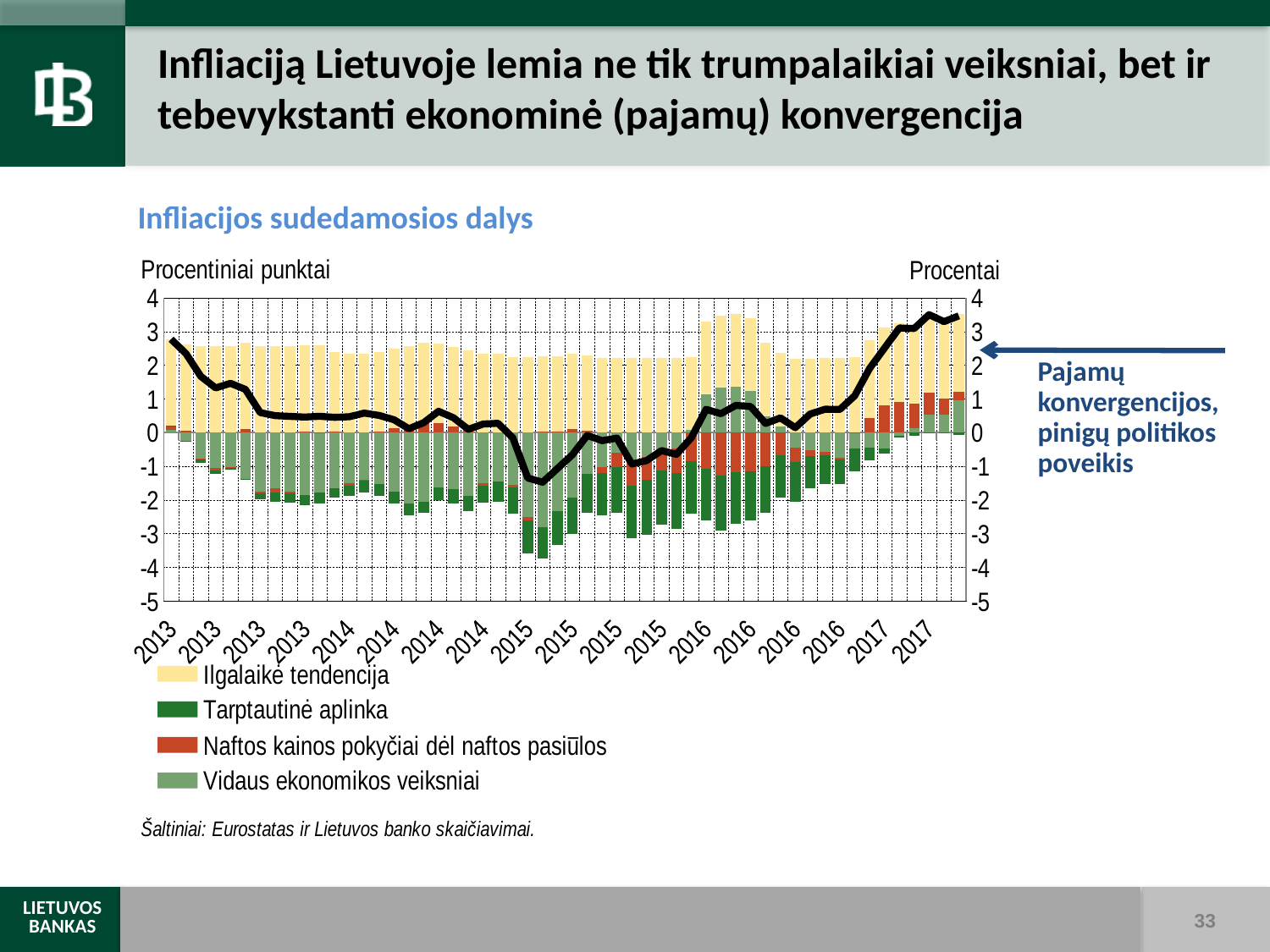
Is the value of the black line at the start of 2013 greater or less than 2? greater Is the lowest value of the black line, reached in 2015, greater or less than -1? less What is the lowest value shown on the vertical axis? -5 What kind of chart is shown on the slide? Stacked bar chart with a line Does the black line rise or fall from the start of 2013 to early 2015? fall What is the title of the chart? Infliacijos sudedamosios dalys Is the value of the black line at the end of 2017 greater or less than 3? greater What is the label of the left vertical axis? Procentiniai punktai Which legend entry is shown in yellow? Ilgalaikė tendencija Does the black line rise or fall from 2016 to 2017? rise How many series does the legend list? 4